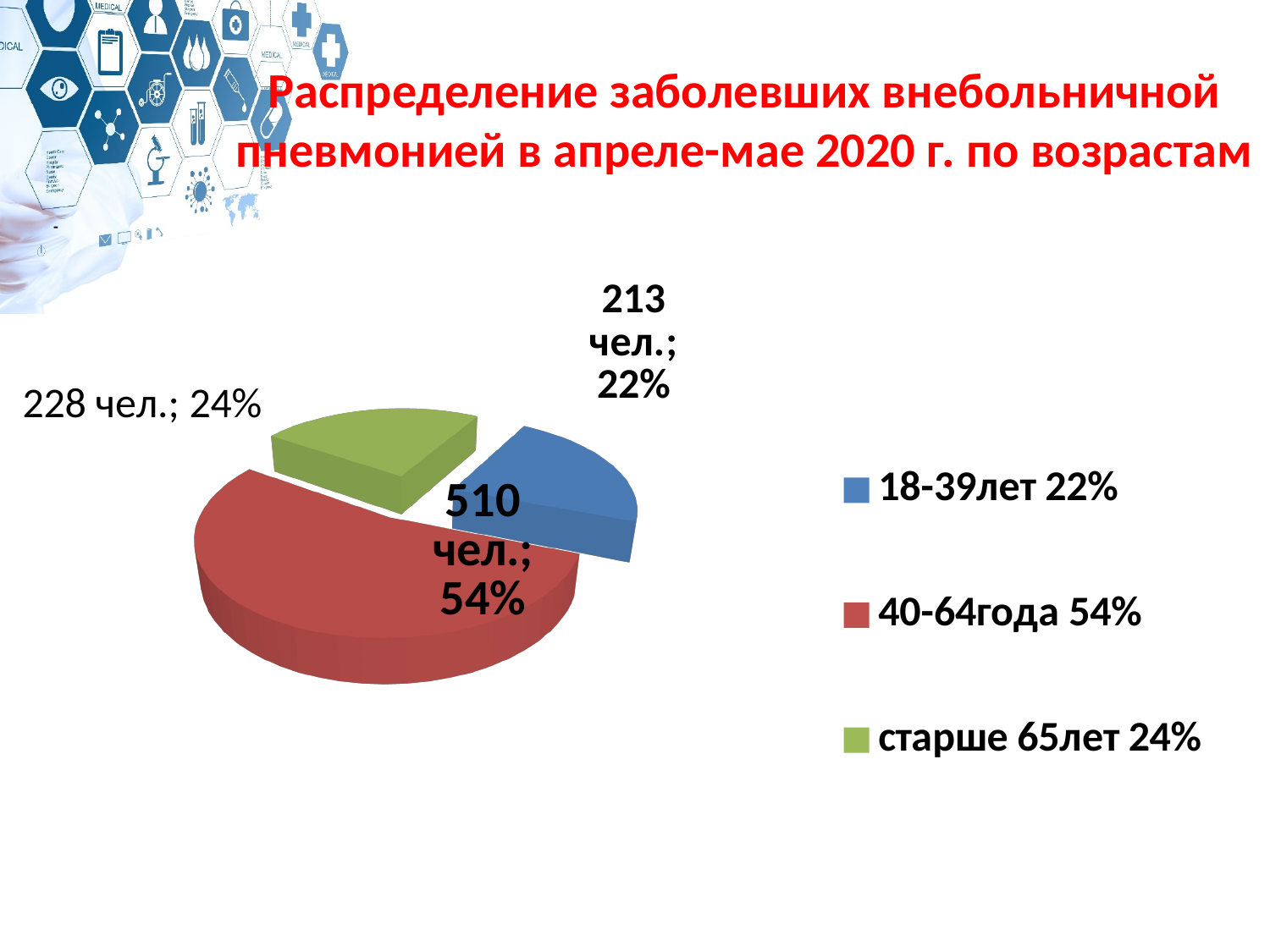
Which age group has the smallest slice of the pie? 18-39 лет How many people in the старше 65 лет group are shown in the pie chart? 228 чел. What kind of chart is shown on the slide? pie chart How many people aged 40-64 года are shown in the pie chart? 510 чел. Which group has more people: старше 65 лет or 18-39 лет? старше 65 лет How many age groups does the pie chart show? 3 What is the difference in number of people between the 40-64 года group and the 18-39 лет group? 297 Which age group has the largest slice of the pie? 40-64 года What share of the pie does the 40-64 года group take? 54% What share of the pie does the старше 65 лет group take? 24% How many people aged 18-39 лет are shown in the pie chart? 213 чел. What colour is the slice for the 40-64 года group? red